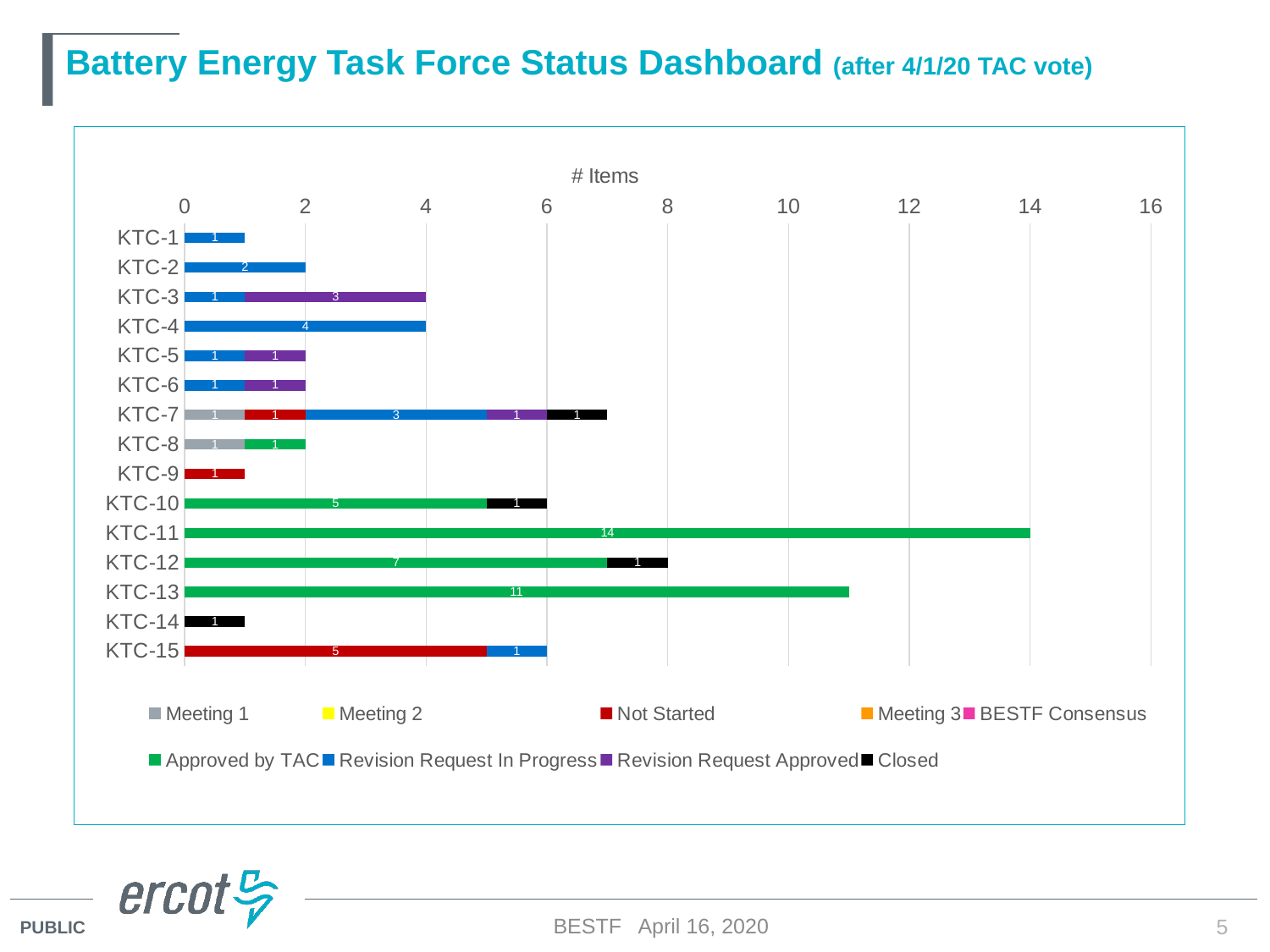
What is the Approved by TAC value for KTC-11? 14 What kind of chart is shown on the slide? Stacked bar chart What is the total number of items for KTC-7? 7 Which has a larger Approved by TAC value, KTC-10 or KTC-12? KTC-12 Which KTC category has the longest total bar? KTC-11 What is the difference between the Approved by TAC values for KTC-11 and KTC-13? 3 What is the Not Started value for KTC-15? 5 How many series does the chart legend list? 9 What is the Revision Request Approved value for KTC-3? 3 What is the Revision Request In Progress value for KTC-7? 3 How many KTC categories are plotted on the chart? 15 What is the total number of items for KTC-12? 8